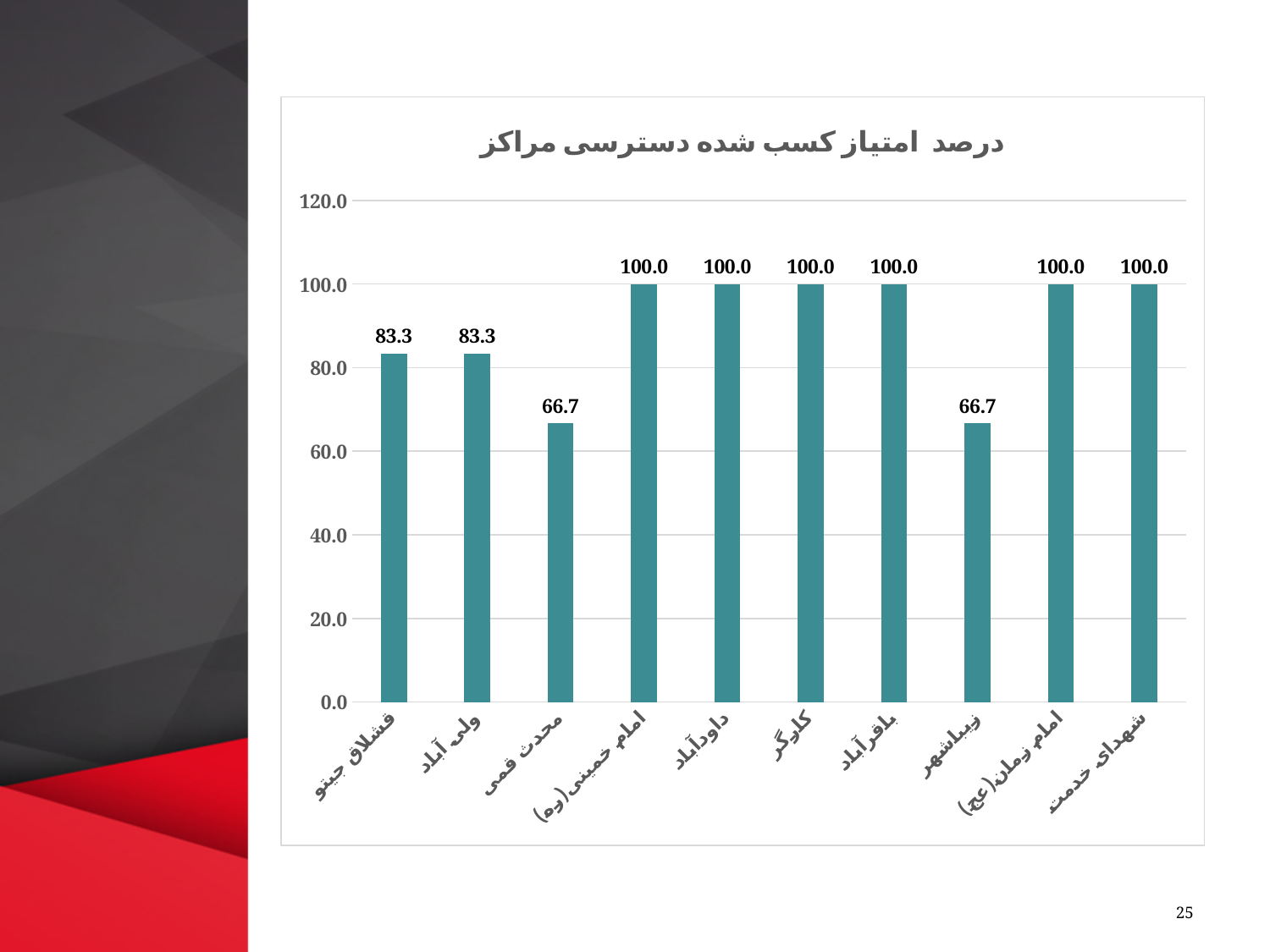
Which is larger, the value for ولی آباد or the value for زیباشهر? ولی آباد What is the value for داودآباد? 100.0 How many categories are shown on the x axis? 10 What is the value for قشلاق جیتو? 83.3 What is the difference between the value for کارگر and the value for ولی آباد? 16.7 What is the value for محدث قمی? 66.7 How many bars have a value of 100.0? 6 What is the title of the chart? درصد امتیاز کسب شده دسترسی مراکز What kind of chart is shown on the slide? Bar chart What is the highest value shown in the chart? 100.0 What is the lowest value shown in the chart? 66.7 What is the value for زیباشهر? 66.7